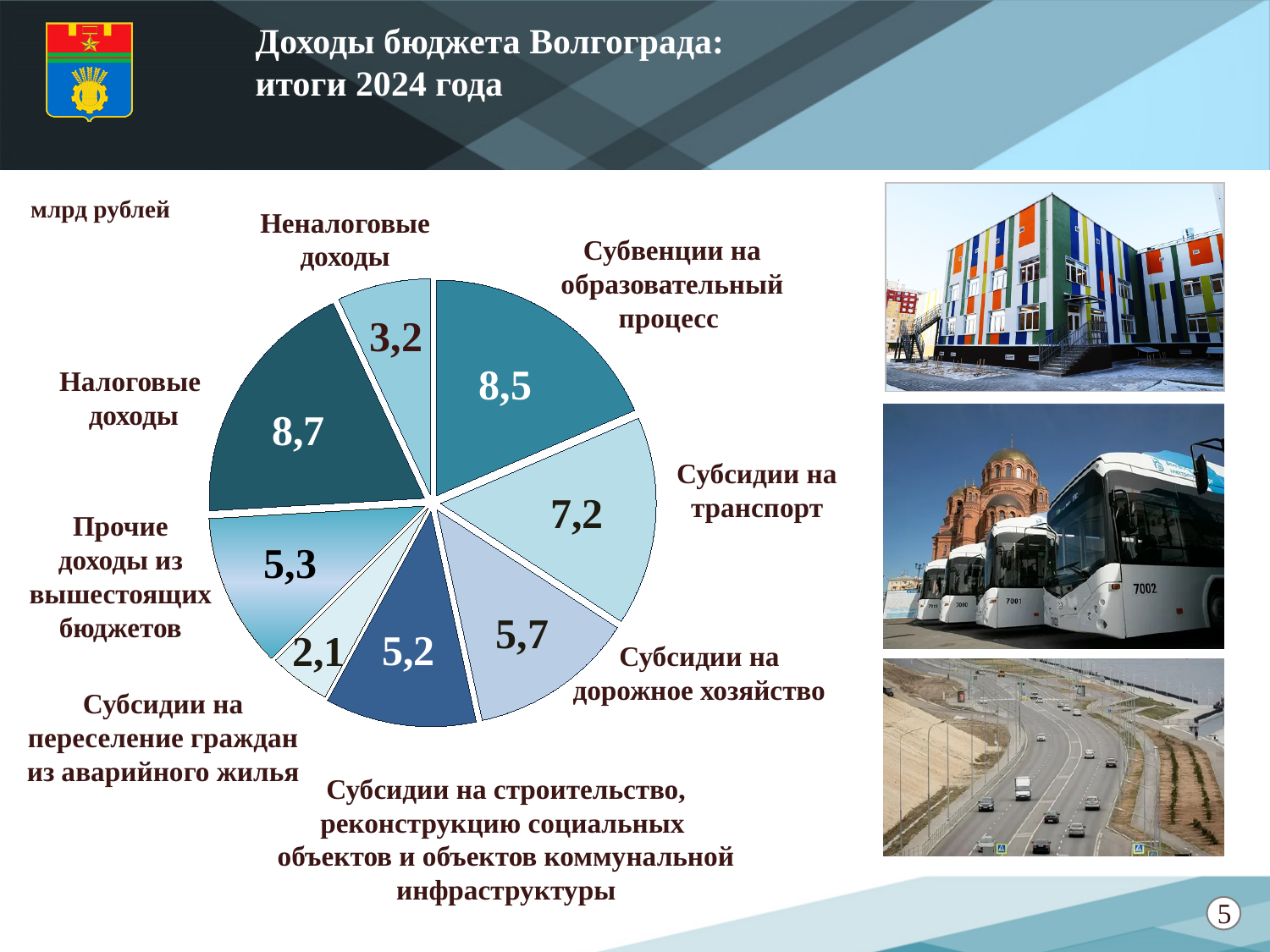
In what units are the values of the pie chart given? млрд рублей What is the value for Субсидии на переселение граждан из аварийного жилья? 2,1 What is the difference between Налоговые доходы and Неналоговые доходы? 5,5 What is the value for Налоговые доходы? 8,7 Which is larger: Прочие доходы из вышестоящих бюджетов or Субсидии на строительство, реконструкцию социальных объектов и объектов коммунальной инфраструктуры? Прочие доходы из вышестоящих бюджетов Which category has the smallest value in the pie chart? Субсидии на переселение граждан из аварийного жилья How many slices does the pie chart have? 8 What type of chart is shown on the slide? Pie chart What is the difference between Субсидии на транспорт and Субсидии на дорожное хозяйство? 1,5 Which category has the largest value in the pie chart? Налоговые доходы What is the value for Субсидии на транспорт? 7,2 What is the value for Субвенции на образовательный процесс? 8,5